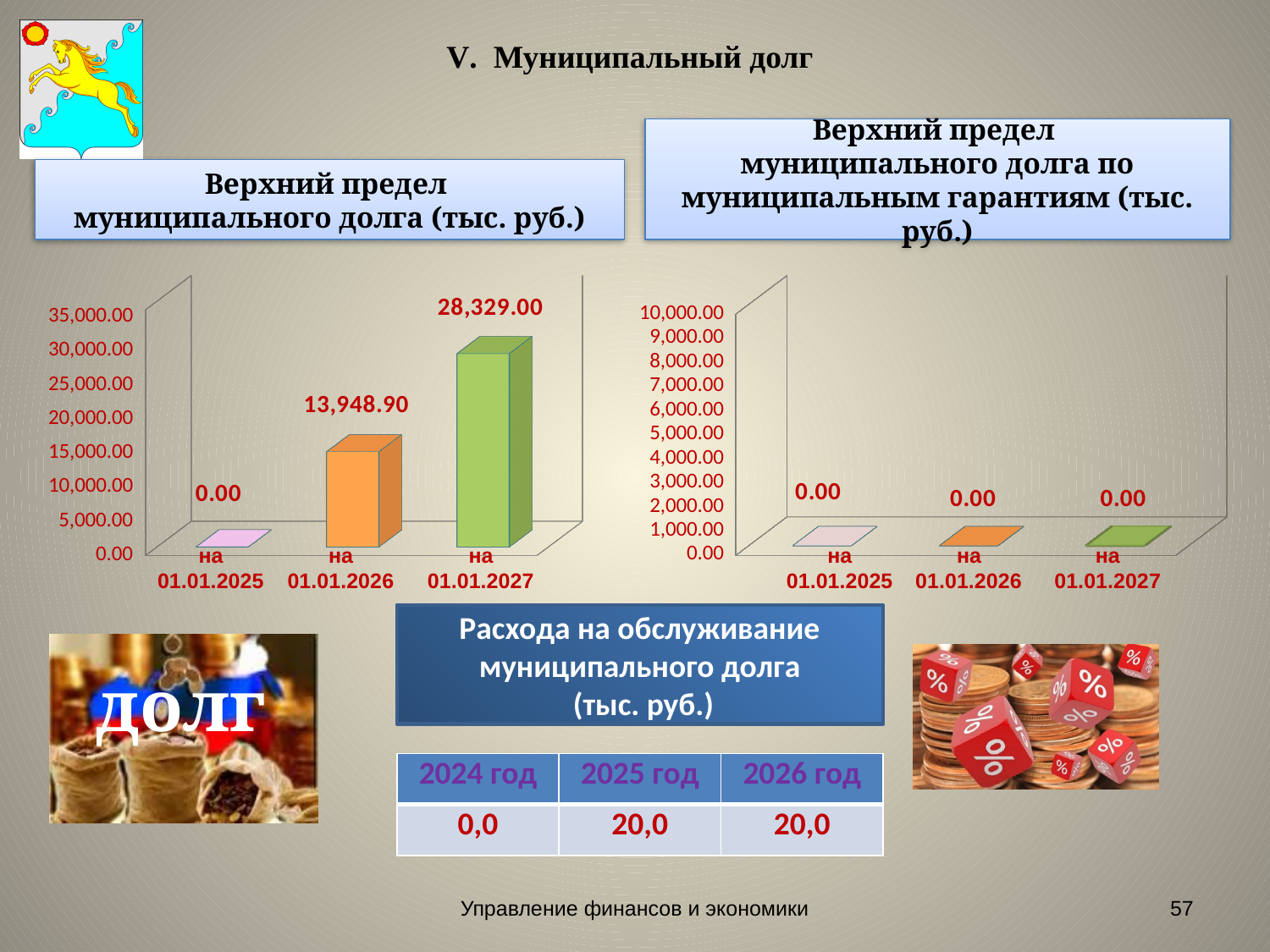
In the left chart (Верхний предел муниципального долга), what is the difference between the values for на 01.01.2027 and на 01.01.2026? 14,380.10 In the left chart (Верхний предел муниципального долга), what is the value for на 01.01.2027? 28,329.00 In the left chart (Верхний предел муниципального долга), which category has the highest value? на 01.01.2027 In the left chart (Верхний предел муниципального долга), which category has the lowest value? на 01.01.2025 In the right chart (Верхний предел муниципального долга по муниципальным гарантиям), what is the value for на 01.01.2027? 0.00 In the left chart (Верхний предел муниципального долга), what is the value for на 01.01.2025? 0.00 In the left chart (Верхний предел муниципального долга), do the values rise or fall from на 01.01.2025 to на 01.01.2027? rise How many categories are shown in the right chart (Верхний предел муниципального долга по муниципальным гарантиям)? 3 In the left chart (Верхний предел муниципального долга), is the value for на 01.01.2026 greater or less than 10,000.00? greater What kind of chart is the left chart (Верхний предел муниципального долга)? bar chart In the left chart (Верхний предел муниципального долга), what is the value for на 01.01.2026? 13,948.90 In the left chart (Верхний предел муниципального долга), which is larger: the value for на 01.01.2026 or на 01.01.2027? на 01.01.2027